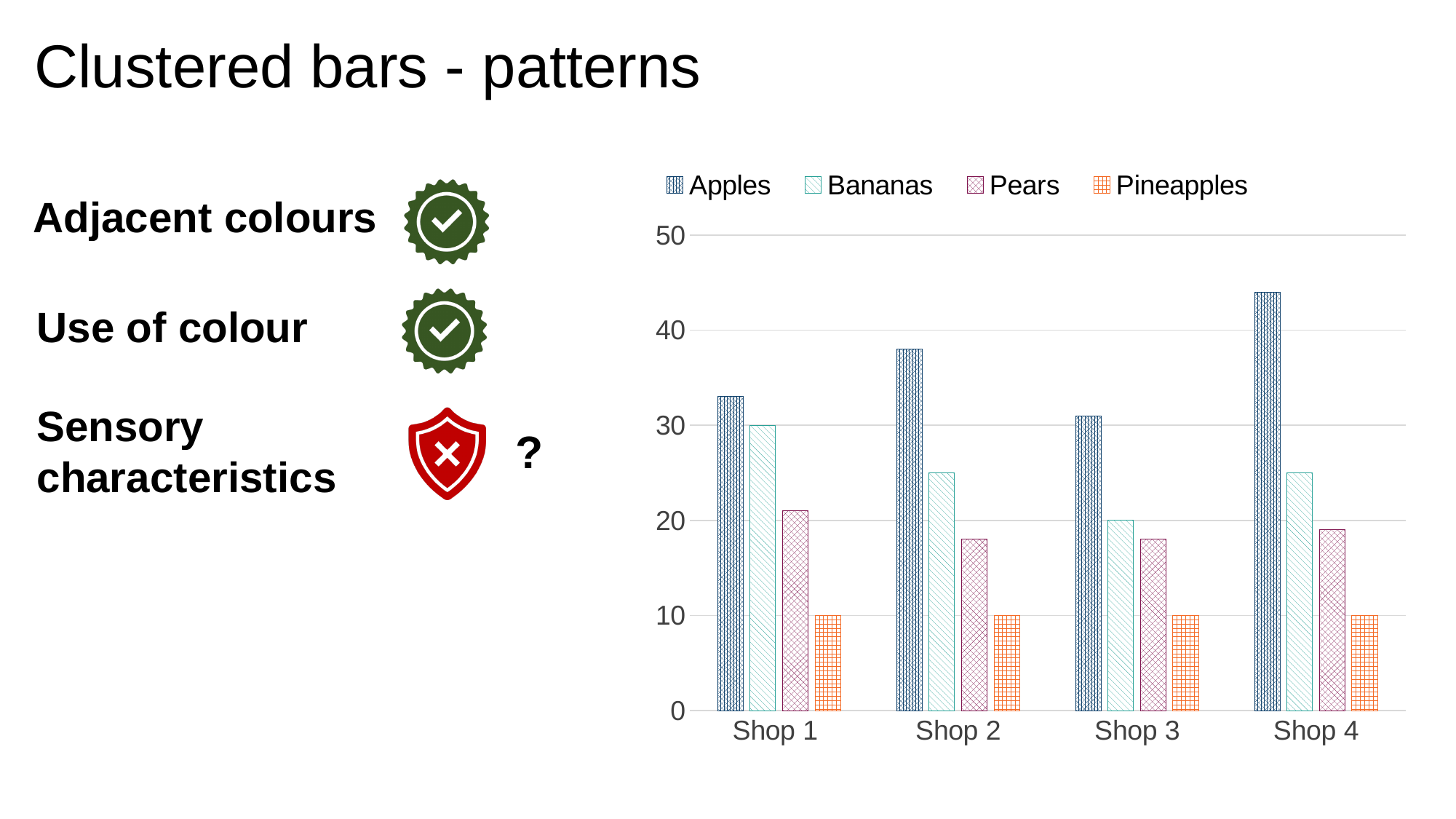
What is the value for Bananas at Shop 1? 30 Which series is listed last in the legend? Pineapples How many series does the legend list? 4 What is the value for Bananas at Shop 3? 20 Which shop has the highest value for Apples? Shop 4 How many shops are shown on the x axis? 4 What is the value for Pineapples at Shop 2? 10 Which is larger at Shop 2, Apples or Bananas? Apples Is the value for Pears at Shop 2 greater or less than 20? less Is the value for Apples at Shop 4 greater or less than 40? greater What kind of chart is shown on the slide? bar chart Which shop has the lowest value for Bananas? Shop 3